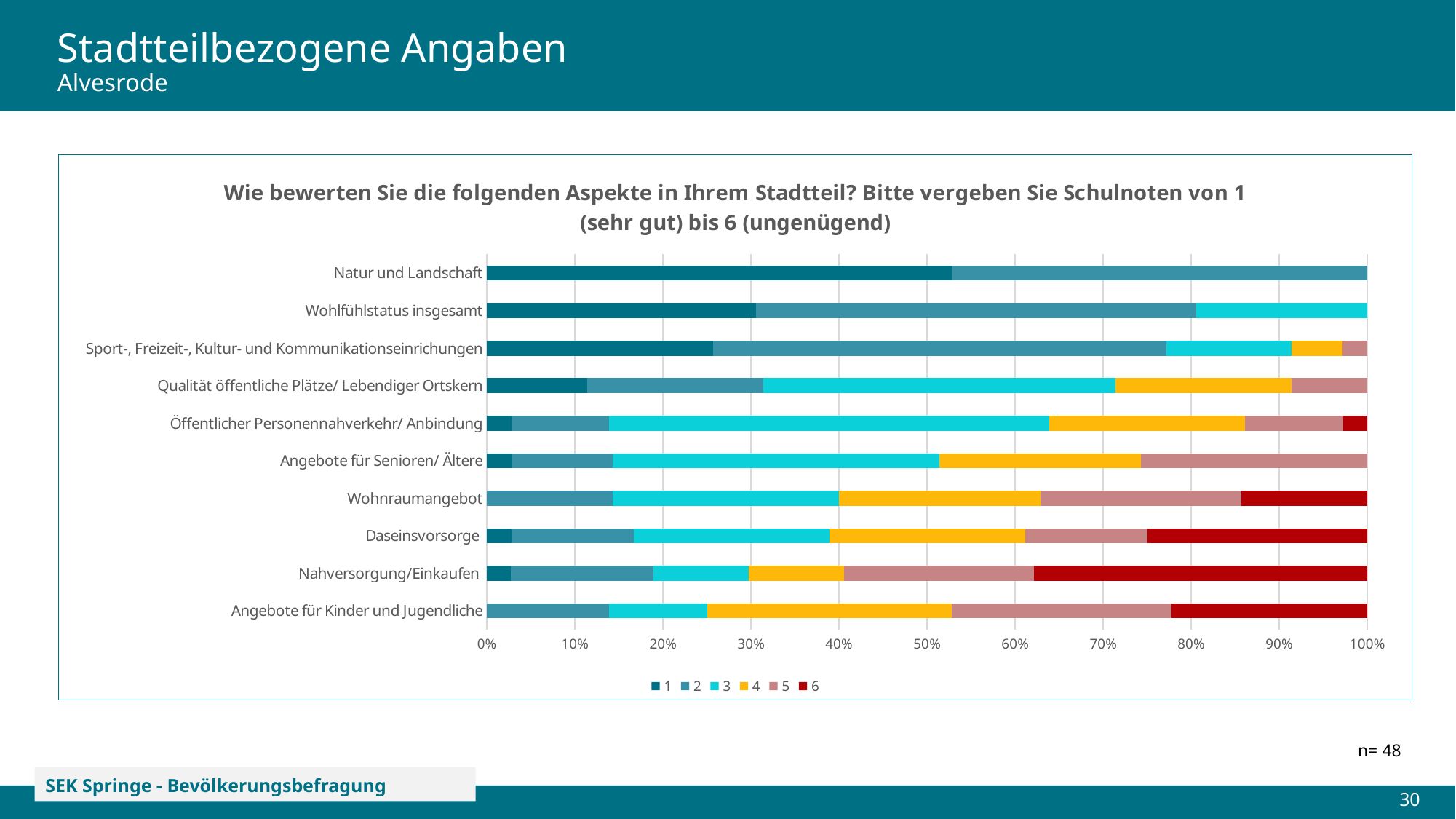
Is the grade 1 share for Natur und Landschaft greater or less than 50%? greater How many categories (aspects) are listed on the vertical axis of the chart? 10 Is the grade 6 share for Nahversorgung/Einkaufen greater or less than 30%? greater What kind of chart is shown on the slide? Stacked bar chart How many series does the chart legend list? 6 Which category has the largest share of grade 1 (dark teal segment)? Natur und Landschaft What value does each stacked bar in the chart total? 100% What is the sample size (n) stated on the slide? n= 48 Which has the larger grade 6 share: Nahversorgung/Einkaufen or Daseinsvorsorge? Nahversorgung/Einkaufen Which category has the largest share of grade 6 (dark red segment)? Nahversorgung/Einkaufen Which has the larger grade 1 share: Natur und Landschaft or Wohlfühlstatus insgesamt? Natur und Landschaft Is the grade 1 share for Wohlfühlstatus insgesamt greater or less than 40%? less